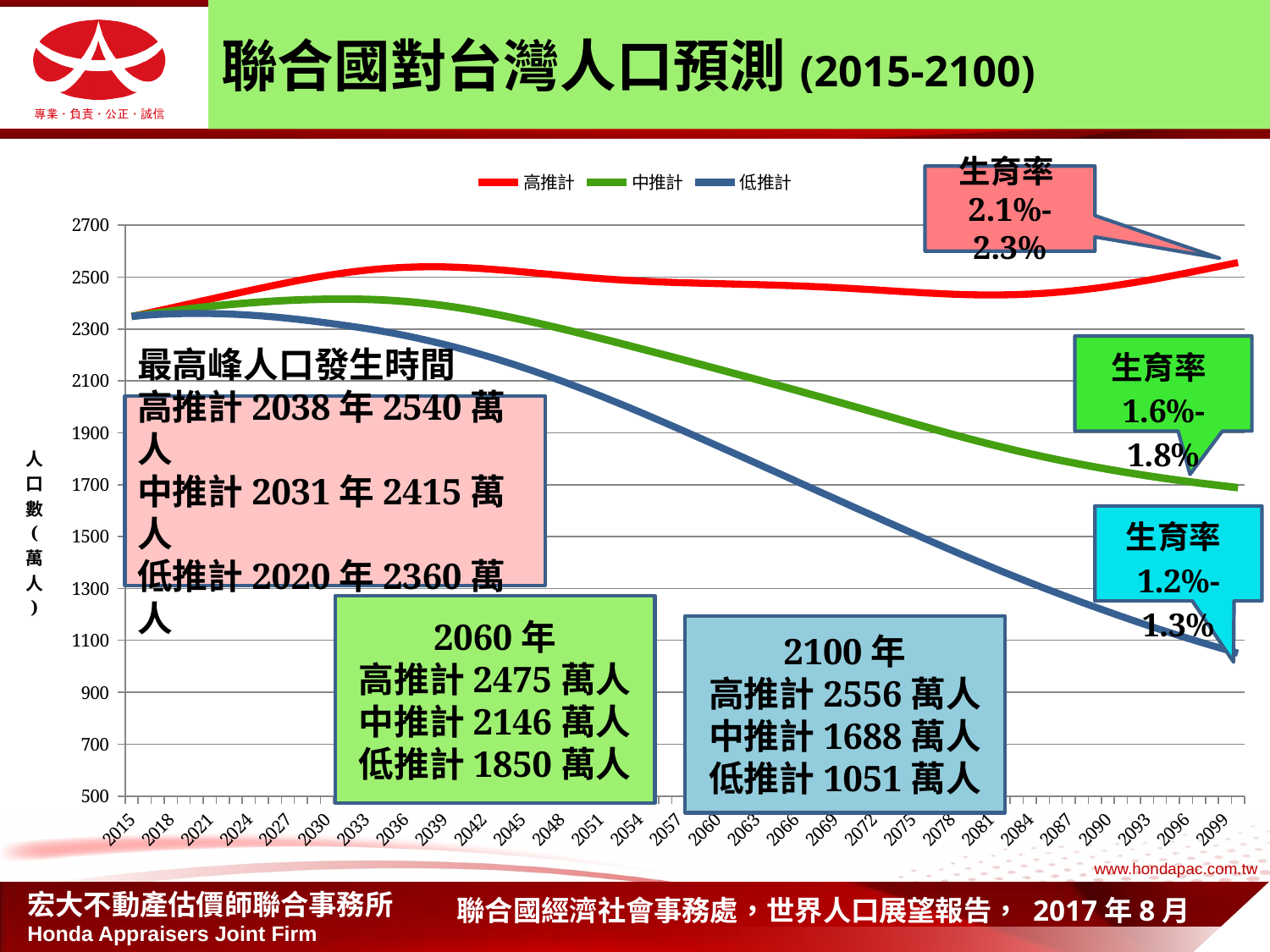
What is the difference between the 高推計 and 中推計 values for 2060年? 329 萬人 How many series does the legend list? 3 In which year does the 高推計 series reach its peak population, according to the annotation? 2038 年 What kind of chart is shown on the slide? line chart According to the annotation, what is the 中推計 population in 2060年? 2146 萬人 Is the 低推計 value at 2099 greater or less than 1300? less What is the difference between the 高推計 and 低推計 values for 2100年? 1505 萬人 Does the 低推計 line rise or fall from 2015 to 2099? fall Which series has the highest value at the right end of the chart (2099)? 高推計 According to the annotation, what is the 低推計 population in 2100年? 1051 萬人 In 2060年, which is larger: 高推計 or 低推計? 高推計 What colour is the 中推計 line in the legend? green